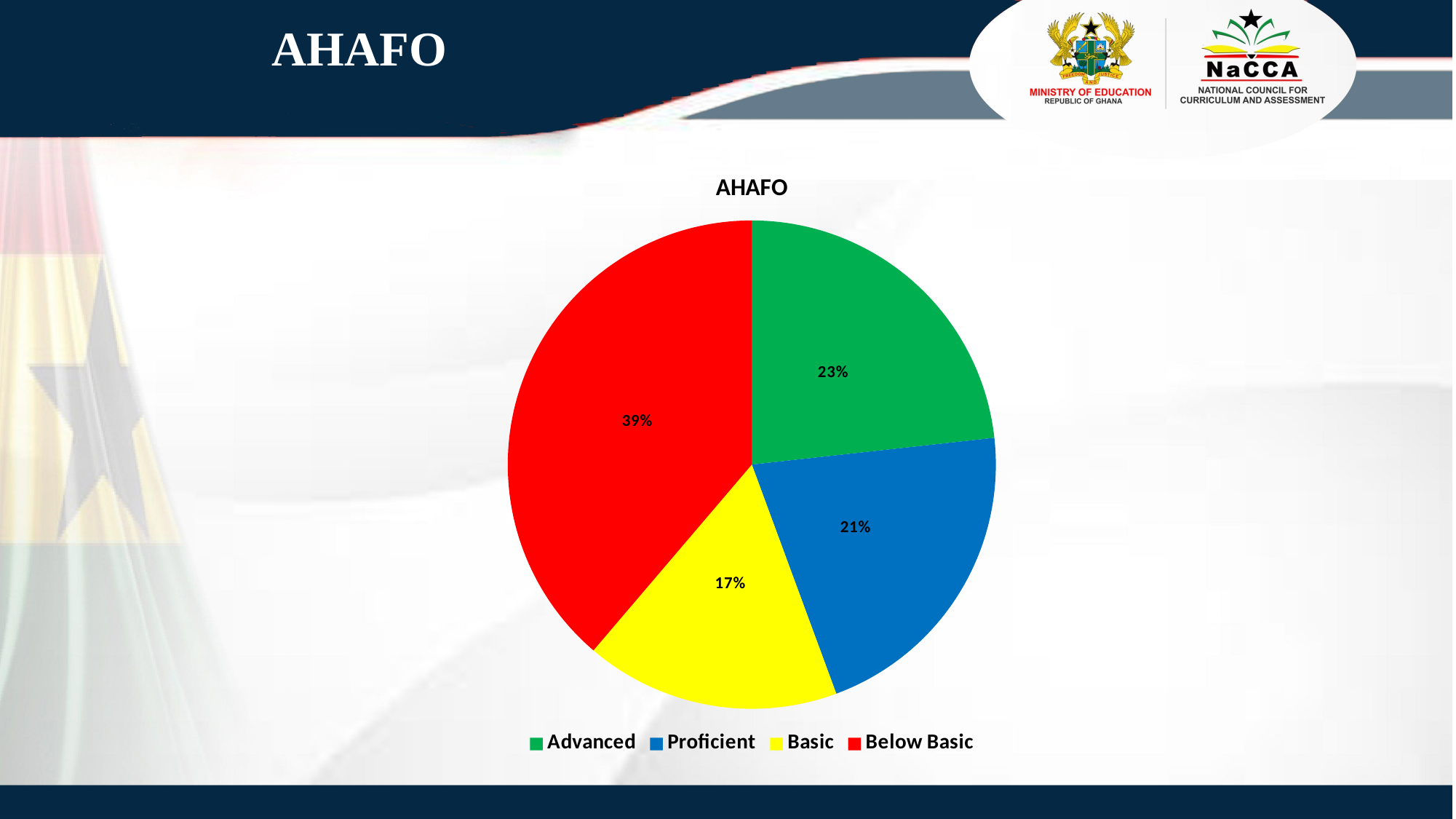
What is the difference in percentage points between Below Basic and Advanced? 16 What colour represents Below Basic in the pie chart? Red What kind of chart is shown on the slide? Pie chart How many categories does the pie chart show? 4 Which category has the smallest share of the pie? Basic What percentage of the pie is labelled Basic? 17% What percentage of the pie is labelled Below Basic? 39% What is the title of the chart? AHAFO What percentage of the pie is labelled Advanced? 23% Which is larger, the Advanced share or the Proficient share? Advanced Which category has the largest share of the pie? Below Basic What percentage of the pie is labelled Proficient? 21%